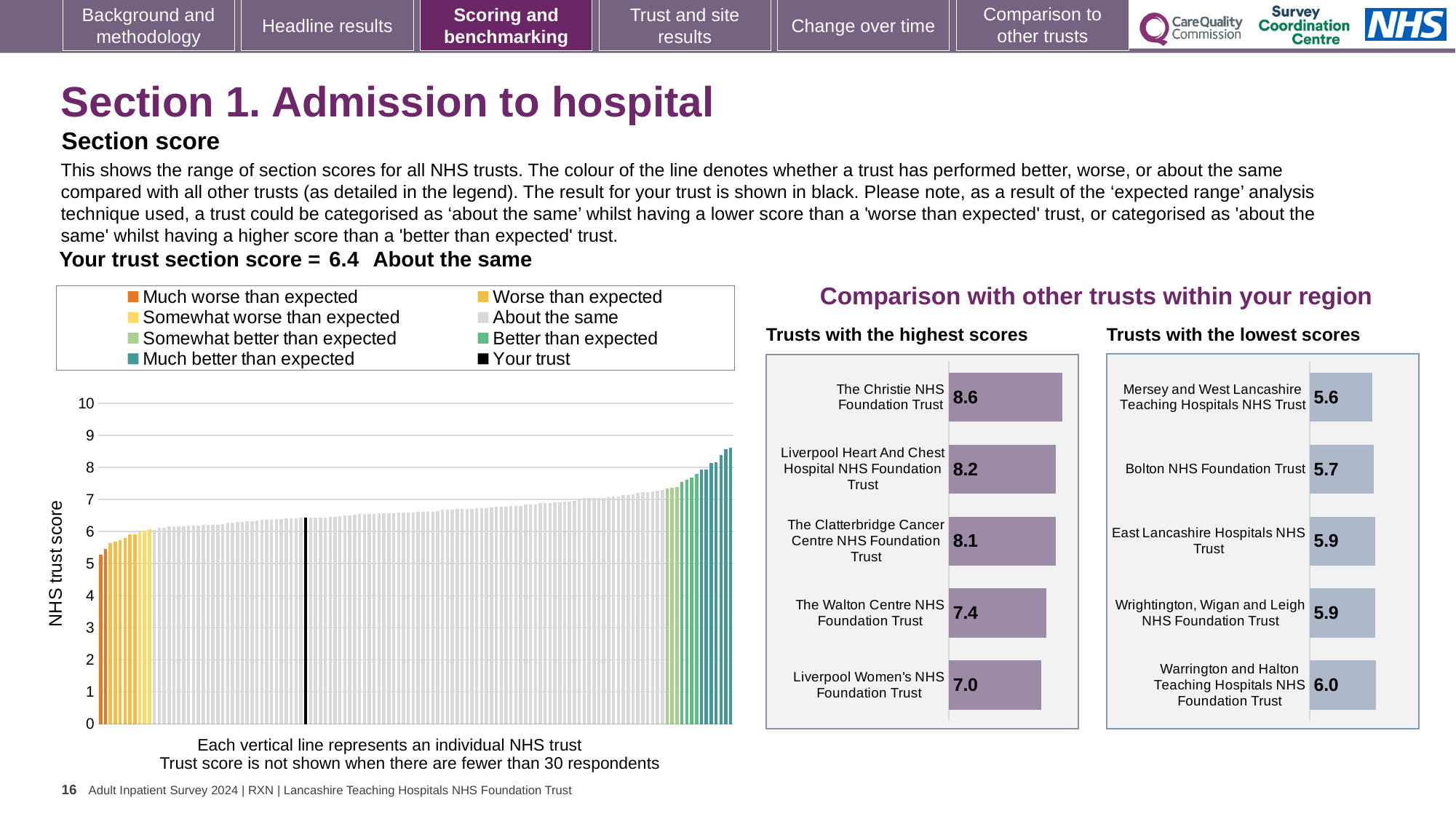
In the 'Trusts with the highest scores' chart, which trust has the lowest score shown? Liverpool Women's NHS Foundation Trust How many entries does the legend of the main 'NHS trust score' chart list? 8 In the main 'NHS trust score' chart on the left, is the value for your trust (the black line) greater or less than 7? less In the 'Trusts with the highest scores' chart, what is the difference between the scores of The Christie NHS Foundation Trust and The Walton Centre NHS Foundation Trust? 1.2 In the 'Trusts with the lowest scores' chart, which trust has the lowest score? Mersey and West Lancashire Teaching Hospitals NHS Trust In the 'Trusts with the highest scores' chart, what is the score for The Christie NHS Foundation Trust? 8.6 In the main 'NHS trust score' chart, what colour represents 'Your trust' according to the legend? black In the 'Trusts with the lowest scores' chart, what is the score for Bolton NHS Foundation Trust? 5.7 In the main 'NHS trust score' chart on the left, do the trust scores rise or fall from left to right? rise In the 'Trusts with the lowest scores' chart, which has the higher score: Bolton NHS Foundation Trust or Warrington and Halton Teaching Hospitals NHS Foundation Trust? Warrington and Halton Teaching Hospitals NHS Foundation Trust In the 'Trusts with the highest scores' chart, how many trusts are listed? 5 What kind of chart is the main 'NHS trust score' chart on the left? bar chart